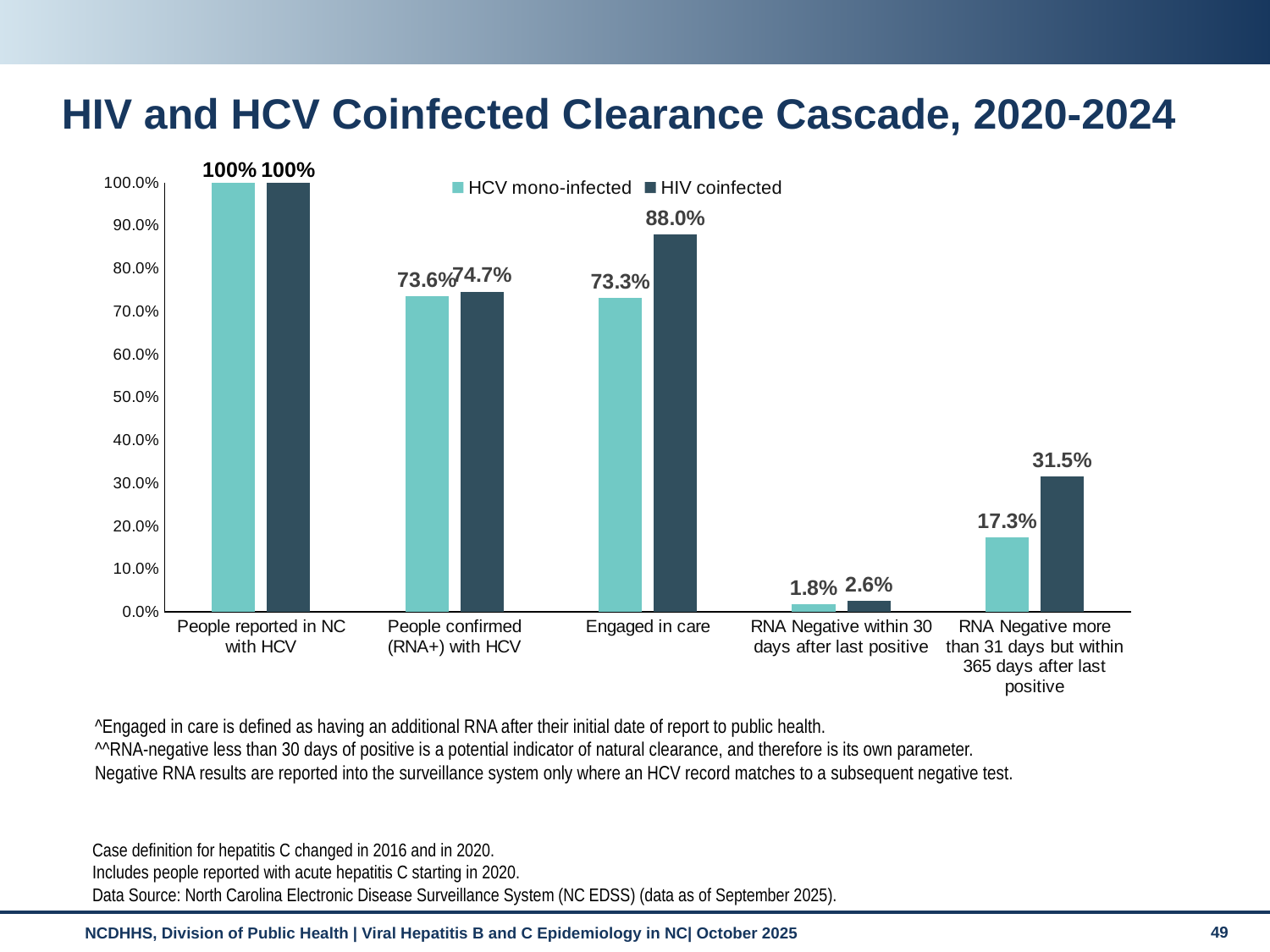
How many series does the legend list? 2 What is the title of the chart? HIV and HCV Coinfected Clearance Cascade, 2020-2024 What is the value for HIV coinfected in the RNA Negative within 30 days after last positive category? 2.6% What is the difference between the HIV coinfected and HCV mono-infected values in the Engaged in care category? 14.7% What is the value for HIV coinfected in the Engaged in care category? 88.0% What is the value for HCV mono-infected in the RNA Negative more than 31 days but within 365 days after last positive category? 17.3% What is the value for HCV mono-infected in the People confirmed (RNA+) with HCV category? 73.6% How many categories are shown on the x axis? 5 What kind of chart is shown on the slide? Bar chart What is the difference between the HIV coinfected and HCV mono-infected values in the RNA Negative more than 31 days but within 365 days after last positive category? 14.2% Which category has the lowest value for HCV mono-infected? RNA Negative within 30 days after last positive In the Engaged in care category, which series has the larger value, HCV mono-infected or HIV coinfected? HIV coinfected